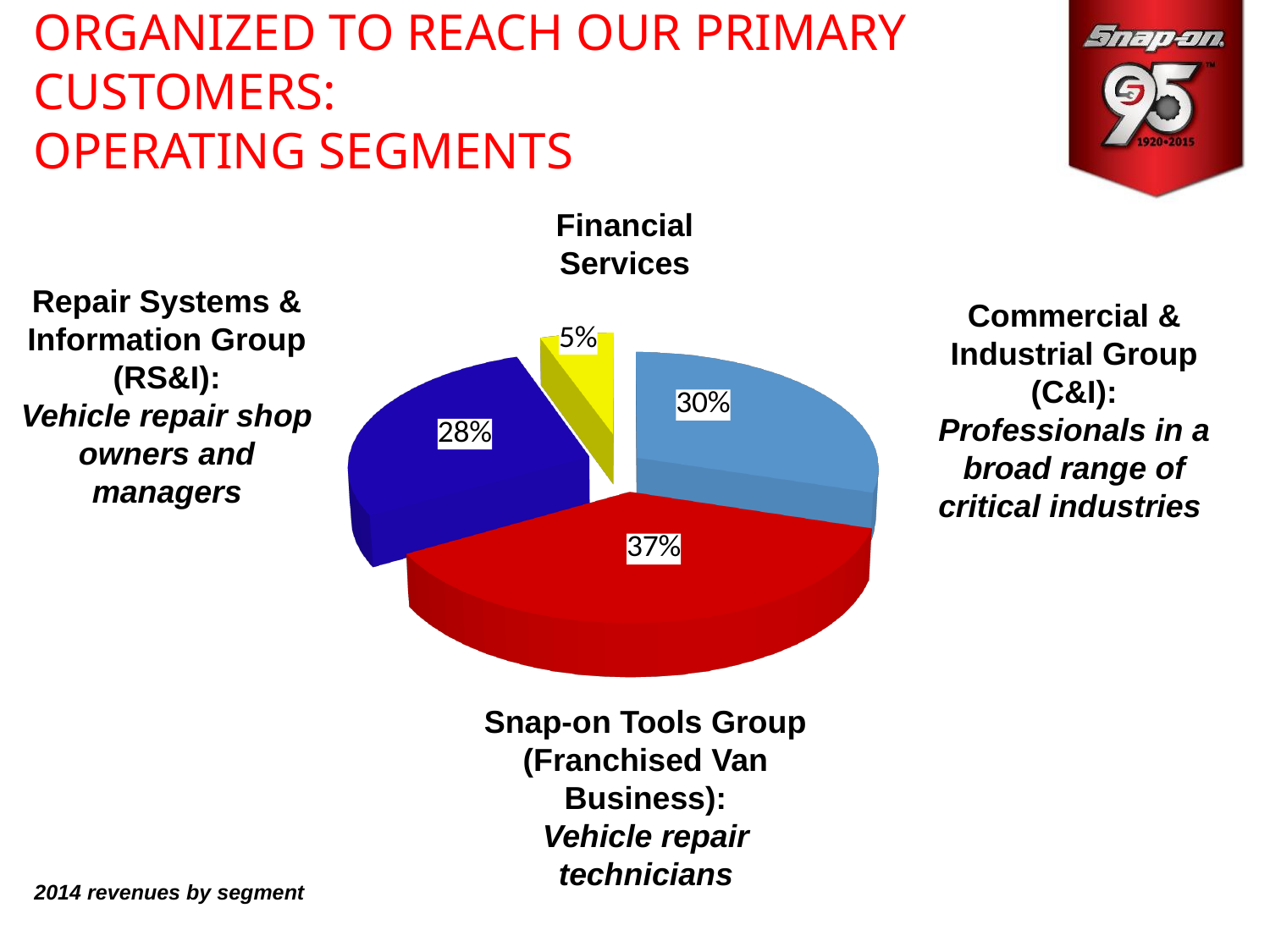
Which segment has the smallest share of 2014 revenues? Financial Services What share of 2014 revenues does the Commercial & Industrial Group (C&I) account for? 30% Which has a larger share of 2014 revenues, the Commercial & Industrial Group or the Repair Systems & Information Group? Commercial & Industrial Group What year's revenues does the pie chart represent, according to the caption? 2014 What is the difference in percentage points between the Snap-on Tools Group share and the Commercial & Industrial Group share? 7 percentage points What type of chart is shown on the slide? Pie chart How many segments are shown in the pie chart? 4 Which segment has the largest share of 2014 revenues? Snap-on Tools Group What share of 2014 revenues does the Snap-on Tools Group account for? 37% What share of 2014 revenues does the Repair Systems & Information Group (RS&I) account for? 28% What colour is the slice representing the Snap-on Tools Group? Red What share of 2014 revenues does Financial Services account for? 5%